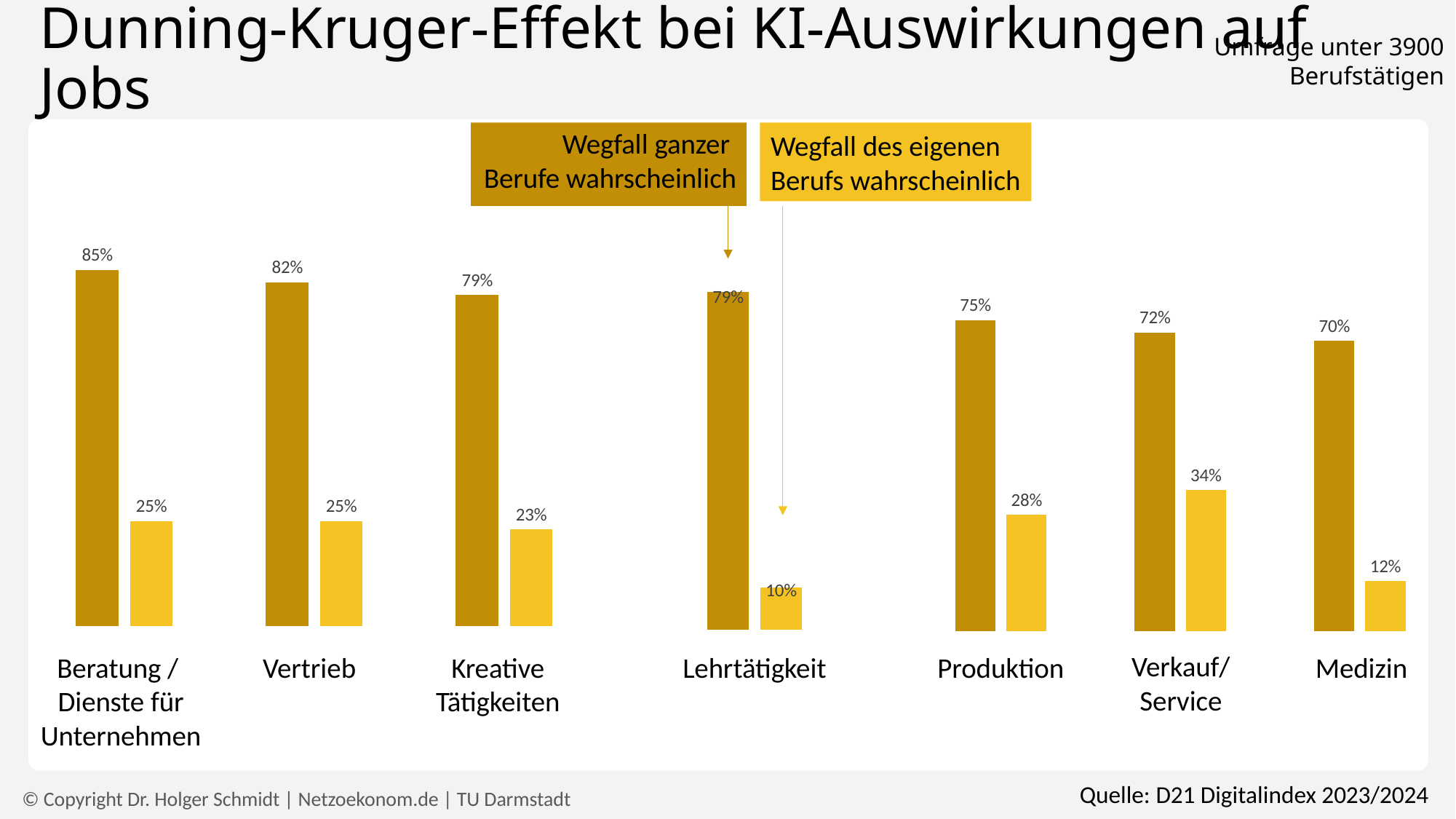
What is the value for 'Wegfall des eigenen Berufs wahrscheinlich' for Lehrtätigkeit? 10% Which category has the highest value for 'Wegfall ganzer Berufe wahrscheinlich'? Beratung / Dienste für Unternehmen Is the 'Wegfall des eigenen Berufs wahrscheinlich' value larger for Produktion or for Medizin? Produktion What kind of chart is shown on the slide? Bar chart Which category has the lowest value for 'Wegfall des eigenen Berufs wahrscheinlich'? Lehrtätigkeit What is the value for 'Wegfall des eigenen Berufs wahrscheinlich' for Verkauf/Service? 34% Do the 'Wegfall ganzer Berufe wahrscheinlich' values rise or fall from left to right along the x axis? Fall What is the difference between the two values shown for Medizin? 58 percentage points How many job categories are shown on the x axis? 7 What is the source cited for the chart? D21 Digitalindex 2023/2024 How many series does the legend list? 2 What is the value for 'Wegfall ganzer Berufe wahrscheinlich' for Beratung / Dienste für Unternehmen? 85%